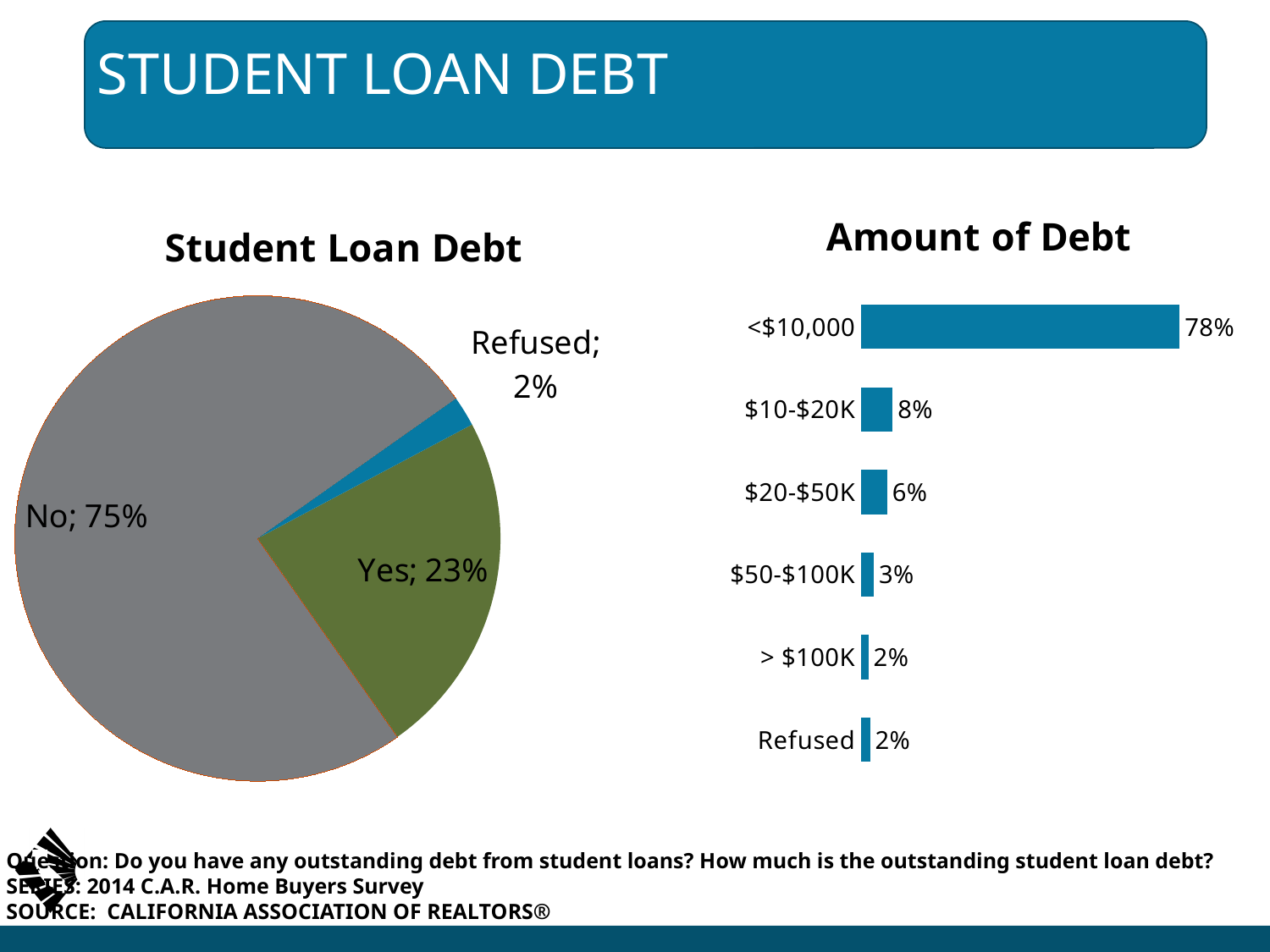
In the 'Amount of Debt' chart, what is the value for <$10,000? 78% In the 'Amount of Debt' chart, what is the value for $20-$50K? 6% In the 'Student Loan Debt' pie chart, what share of respondents answered Yes? 23% In the 'Student Loan Debt' pie chart, what share of respondents answered No? 75% What kind of chart is the 'Student Loan Debt' chart? Pie chart In the 'Amount of Debt' chart, which is larger, the value for $10-$20K or the value for > $100K? $10-$20K In the 'Amount of Debt' chart, which category has the highest value? <$10,000 In the 'Student Loan Debt' pie chart, which category has the largest slice? No What kind of chart is the 'Amount of Debt' chart? Bar chart In the 'Student Loan Debt' pie chart, how many slices are there? 3 In the 'Amount of Debt' chart, what is the difference between the values for $10-$20K and $50-$100K? 5% In the 'Student Loan Debt' pie chart, which category has the smallest slice? Refused